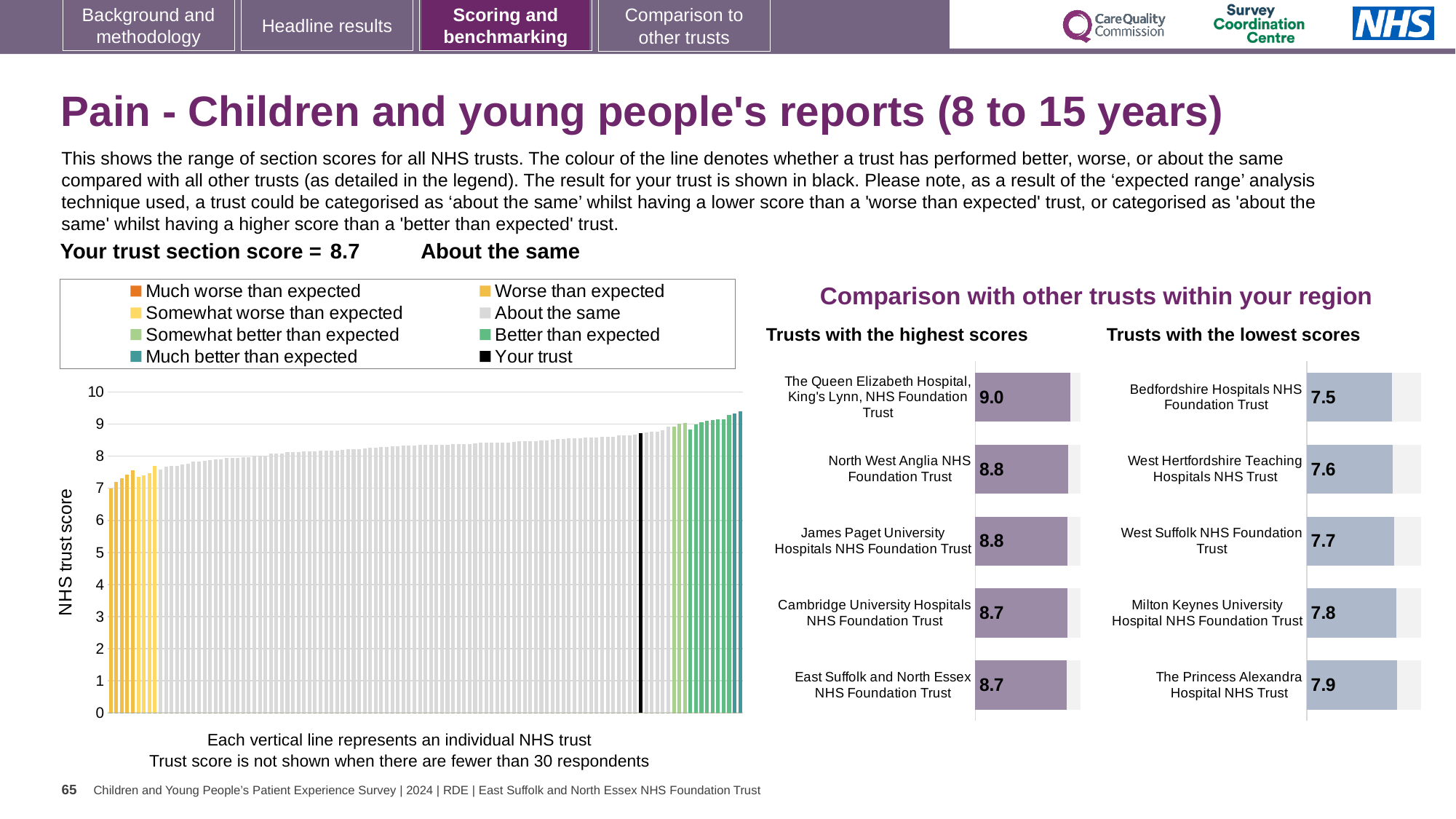
In the 'Trusts with the lowest scores' chart, what is the difference between the scores of The Princess Alexandra Hospital NHS Trust and Bedfordshire Hospitals NHS Foundation Trust? 0.4 In the 'Trusts with the lowest scores' chart, which trust has the lowest score? Bedfordshire Hospitals NHS Foundation Trust In the 'Trusts with the lowest scores' chart, what is the score for Bedfordshire Hospitals NHS Foundation Trust? 7.5 In the 'Trusts with the highest scores' chart, which trust has the highest score? The Queen Elizabeth Hospital, King's Lynn, NHS Foundation Trust In the 'NHS trust score' chart on the left, what colour is used for 'Your trust'? Black How many entries does the legend of the 'NHS trust score' chart on the left list? 8 In the 'Trusts with the lowest scores' chart, which has the higher score: West Suffolk NHS Foundation Trust or Milton Keynes University Hospital NHS Foundation Trust? Milton Keynes University Hospital NHS Foundation Trust In the 'Trusts with the highest scores' chart, what is the score for The Queen Elizabeth Hospital, King's Lynn, NHS Foundation Trust? 9.0 How many trusts are listed in the 'Trusts with the highest scores' chart? 5 What kind of chart is the 'NHS trust score' chart on the left of the slide? Bar chart In the 'NHS trust score' chart on the left, do the values rise or fall from left to right? Rise In the 'Trusts with the highest scores' chart, what is the difference between the scores of The Queen Elizabeth Hospital, King's Lynn and East Suffolk and North Essex NHS Foundation Trust? 0.3